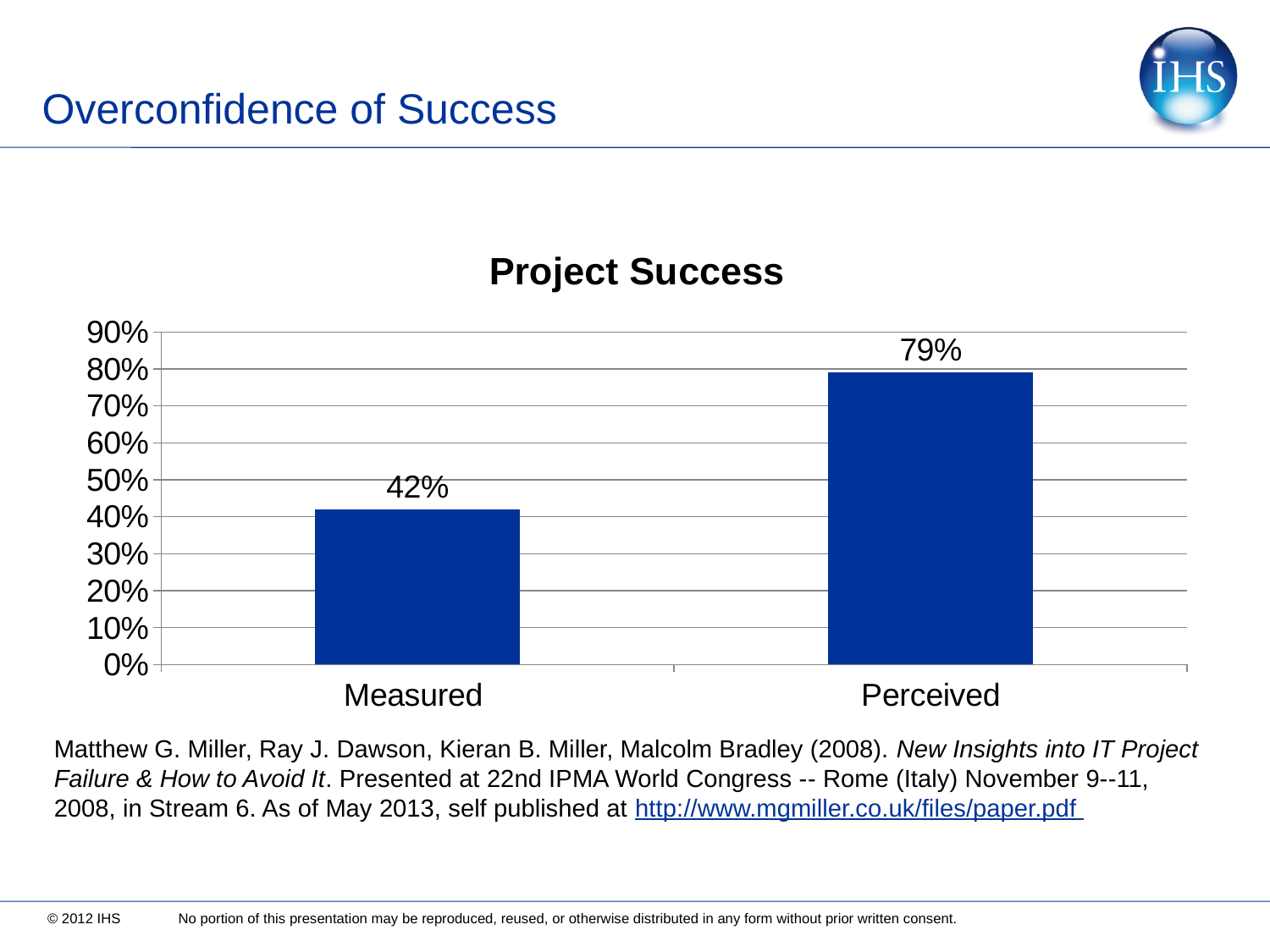
Is the value for Measured greater or less than 50%? less What is the value for Perceived in the Project Success chart? 79% What is the highest value shown on the vertical axis of the Project Success chart? 90% How many categories are shown in the Project Success chart? 2 Which category has the highest value in the Project Success chart? Perceived What is the title of the chart on the slide? Project Success What kind of chart is shown on the slide? Bar chart Is the value for Perceived greater or less than 70%? greater Which is larger in the Project Success chart, Measured or Perceived? Perceived What is the value for Measured in the Project Success chart? 42% What is the difference between the Perceived and Measured values in the Project Success chart? 37% Which category has the lowest value in the Project Success chart? Measured